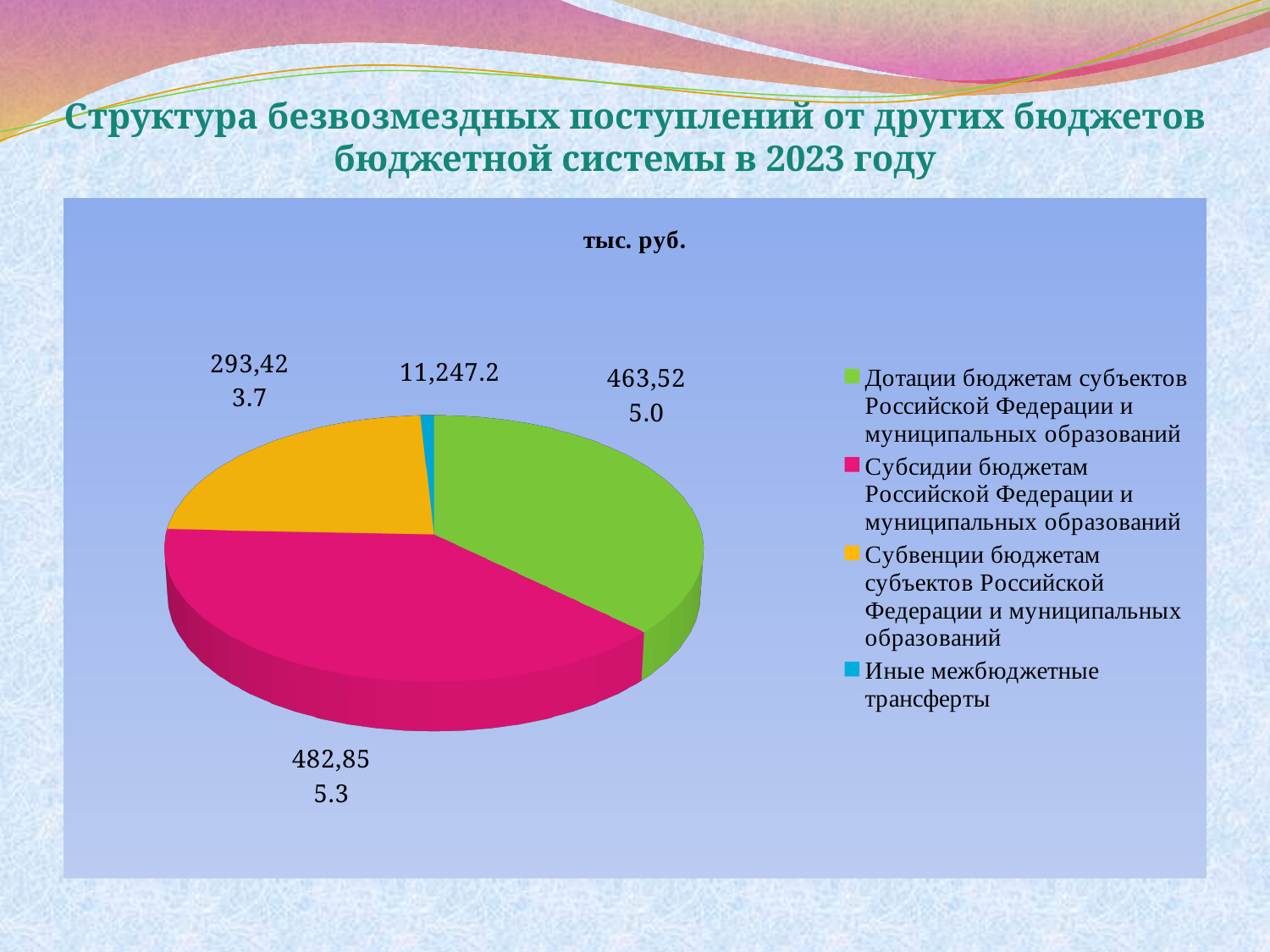
What is the value for "Дотации бюджетам субъектов Российской Федерации и муниципальных образований"? 463,525.0 What unit is given in the chart title? тыс. руб. How many slices does the pie chart have? 4 Which category has the smallest slice of the pie? Иные межбюджетные трансферты Which category has the largest slice of the pie? Субсидии бюджетам Российской Федерации и муниципальных образований What is the value for "Субсидии бюджетам Российской Федерации и муниципальных образований"? 482,855.3 What is the value for "Иные межбюджетные трансферты"? 11,247.2 What is the difference between the values for "Субсидии" and "Дотации"? 19,330.3 How many entries does the legend of the pie chart list? 4 What kind of chart is shown on the slide? pie chart Which is larger: the value for "Субвенции" or the value for "Иные межбюджетные трансферты"? Субвенции What is the value for "Субвенции бюджетам субъектов Российской Федерации и муниципальных образований"? 293,423.7